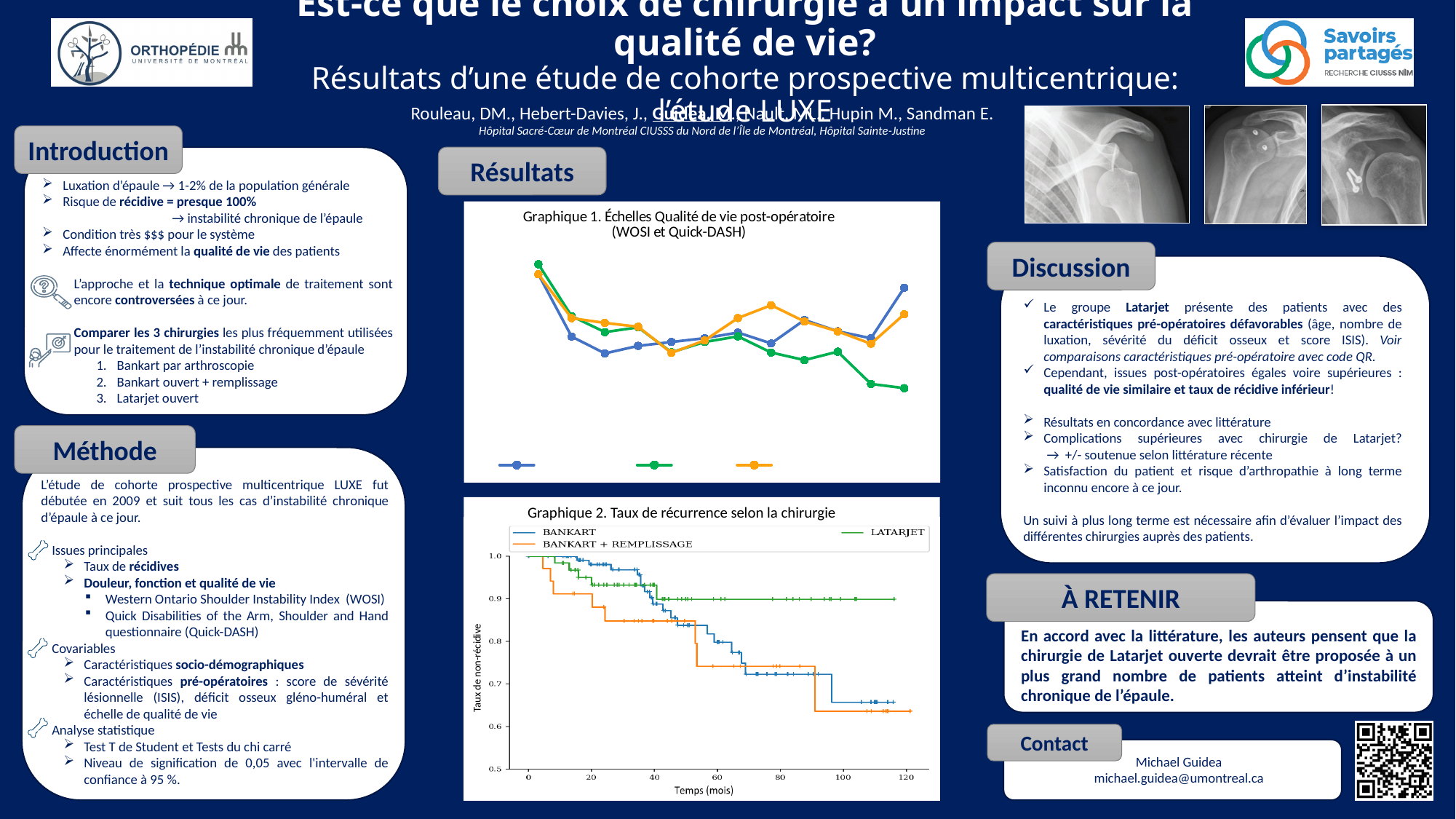
In Graphique 2 (Taux de récurrence selon la chirurgie), which series has the highest value at the end of the follow-up period? LATARJET In Graphique 2 (Taux de récurrence selon la chirurgie), is the final value of the BANKART + REMPLISSAGE curve greater or less than 0.7? less In Graphique 2 (Taux de récurrence selon la chirurgie), do the curves rise or fall as time increases along the x axis? fall In Graphique 2 (Taux de récurrence selon la chirurgie), is the final value of the LATARJET curve greater or less than 0.8? greater How many series are plotted in Graphique 1 (Échelles Qualité de vie post-opératoire)? 3 What kind of chart is Graphique 1 (Échelles Qualité de vie post-opératoire)? line chart In Graphique 2 (Taux de récurrence selon la chirurgie), is the final value of the BANKART curve greater or less than 0.7? less What is the label of the x axis in Graphique 2 (Taux de récurrence selon la chirurgie)? Temps (mois) What kind of chart is Graphique 2 (Taux de récurrence selon la chirurgie)? line chart What is the title of the upper chart on the slide? Graphique 1. Échelles Qualité de vie post-opératoire (WOSI et Quick-DASH) How many series does the legend of Graphique 2 (Taux de récurrence selon la chirurgie) list? 3 In Graphique 2 (Taux de récurrence selon la chirurgie), which curve is higher at 100 months: LATARJET or BANKART? LATARJET